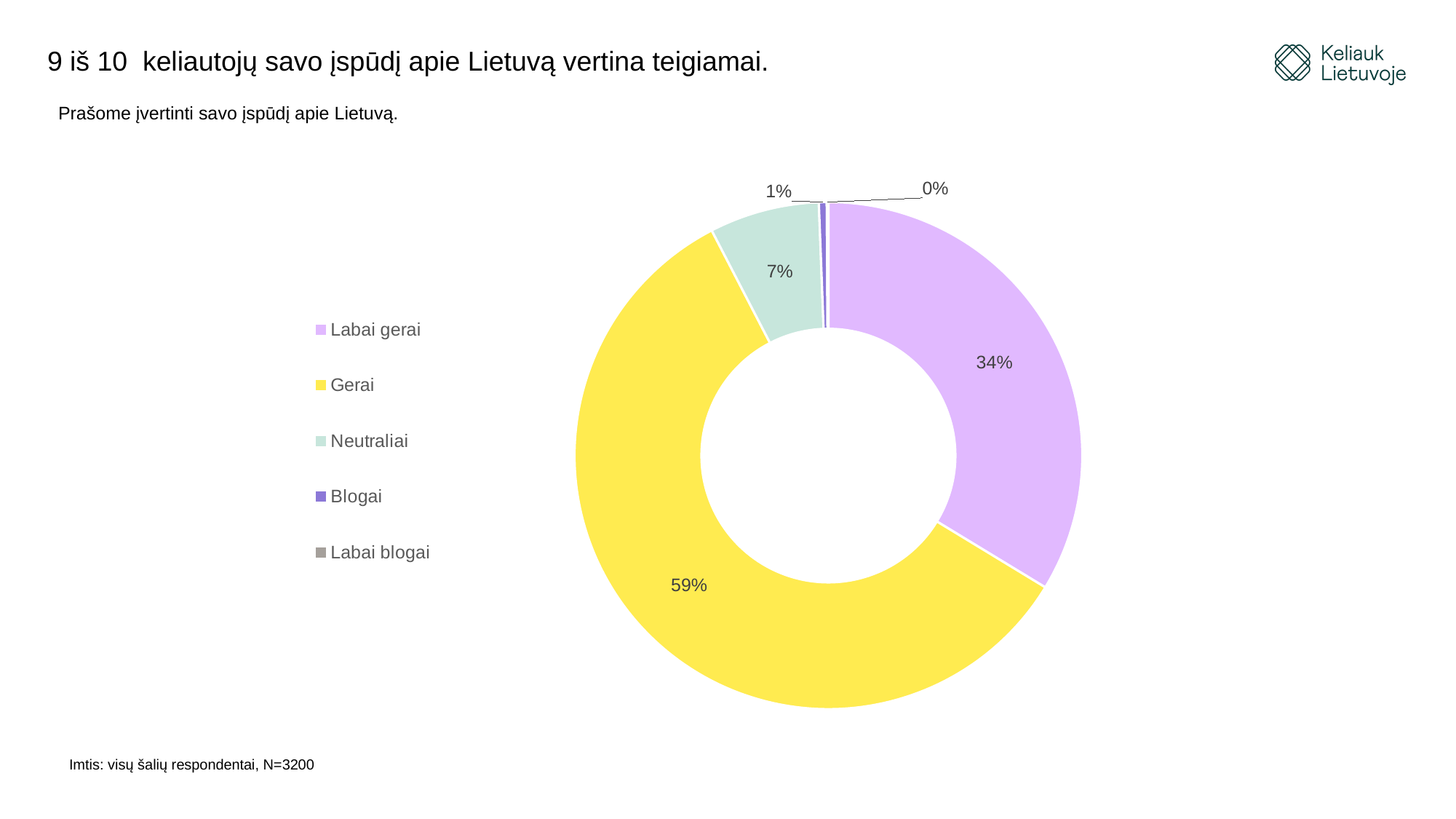
Which category has the smallest share of the pie? Labai blogai What share of respondents answered "Neutraliai"? 7% What is the difference in percentage points between "Gerai" and "Labai gerai"? 25 What share of respondents answered "Blogai"? 1% What share of respondents answered "Labai blogai"? 0% Which is larger, the share for "Neutraliai" or the share for "Blogai"? Neutraliai What kind of chart is shown on the slide? Pie chart (donut) What share of respondents answered "Labai gerai"? 34% How many categories does the legend list? 5 Which category has the largest share of the pie? Gerai What colour represents "Gerai" in the chart? Yellow What share of respondents answered "Gerai"? 59%